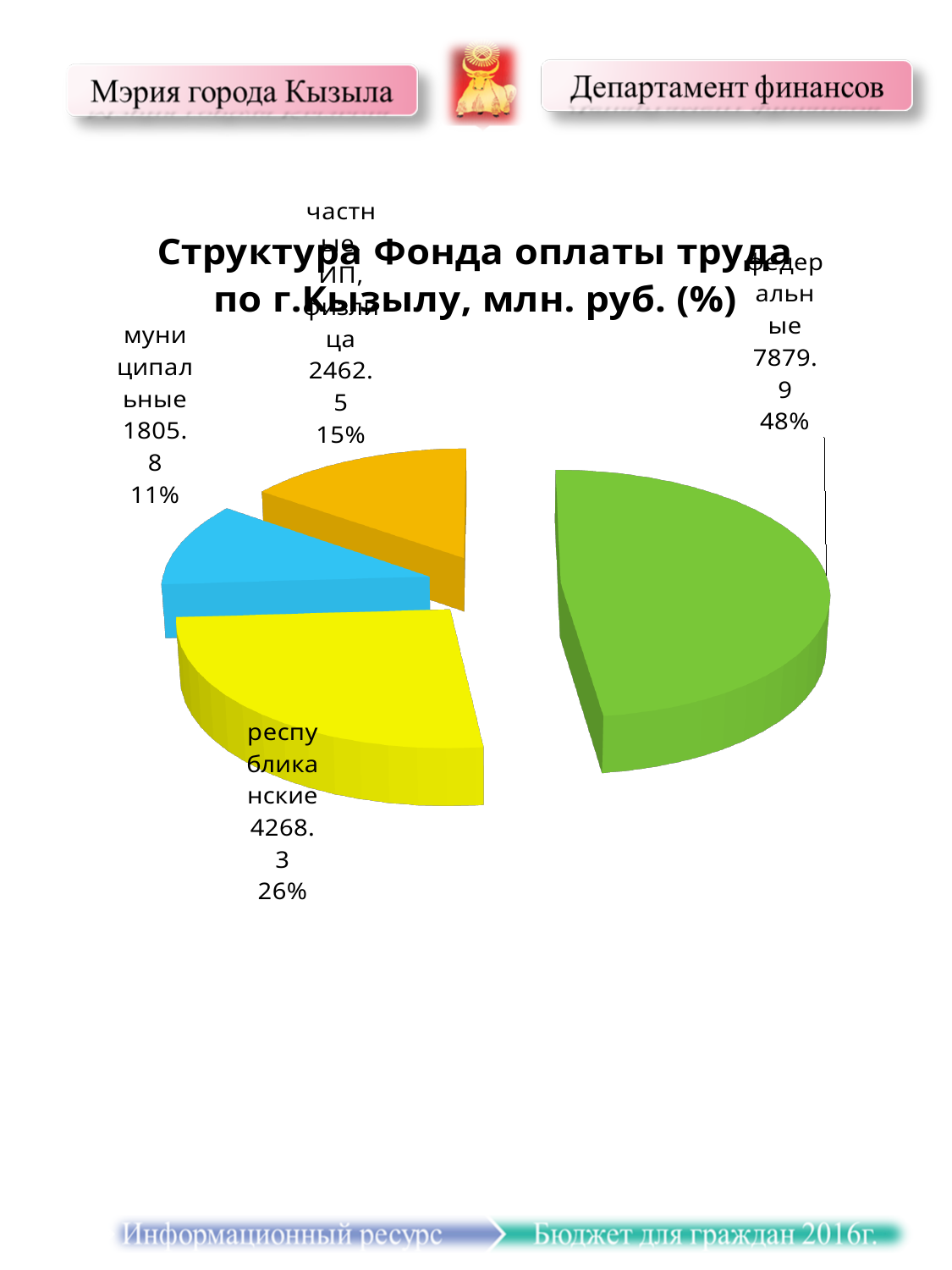
What share of the pie does республиканские take? 26% What is the value for муниципальные? 1805.8 What is the value for республиканские? 4268.3 What is the value for федеральные? 7879.9 What share of the pie does the orange slice (частные, ИП, физлица) take? 15% What share of the pie does федеральные take? 48% What kind of chart is shown on the slide? pie chart Which category has the smallest slice? муниципальные What is the title of the chart? Структура Фонда оплаты труда по г.Кызылу, млн. руб. (%) How many slices does the pie chart have? 4 Which category has the largest slice? федеральные